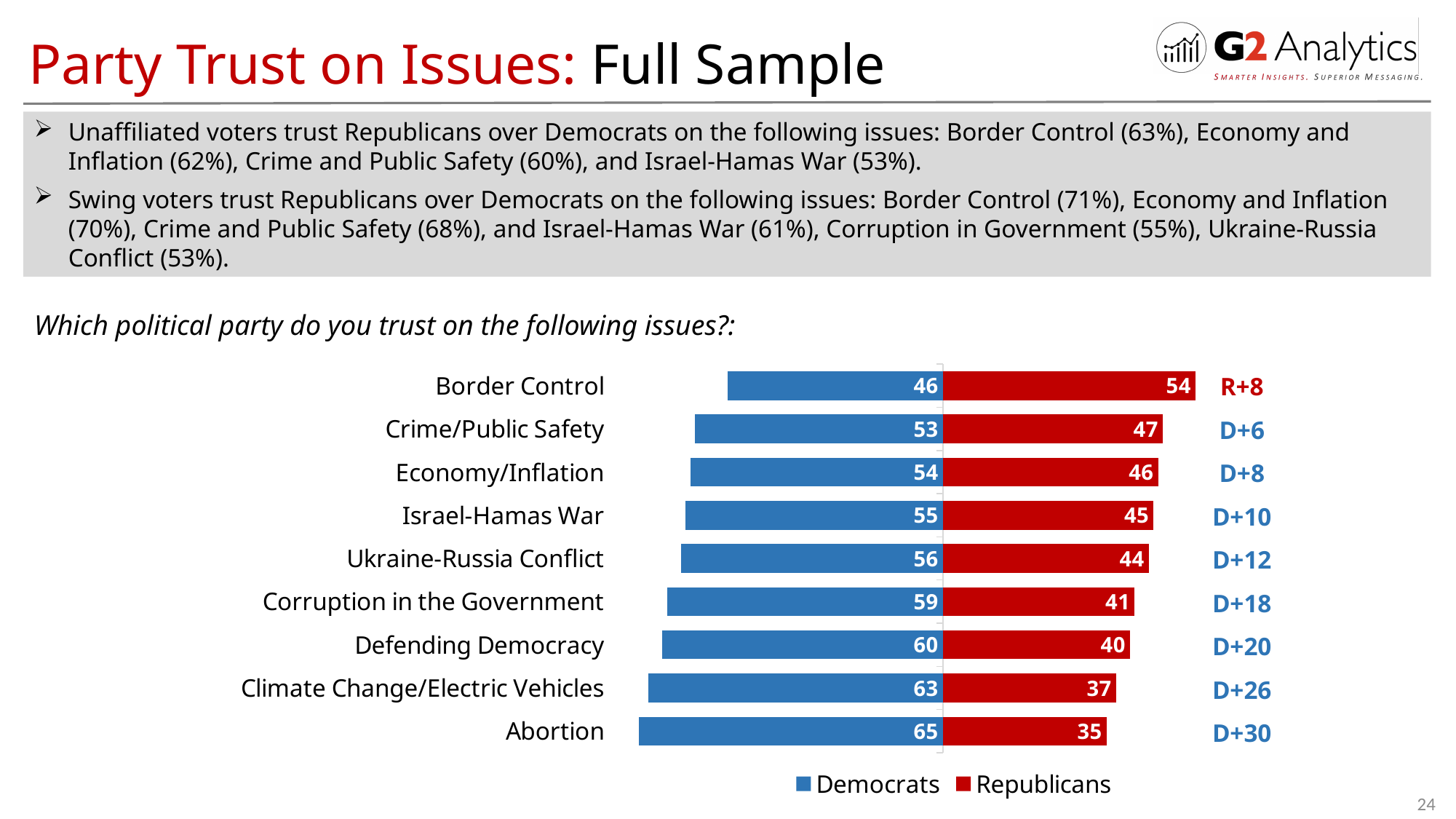
How many issues are shown in the chart? 9 Which issue has the highest Republicans value? Border Control What is the Democrats value for Corruption in the Government? 59 How many series does the legend list? 2 What is the total of the Democrats and Republicans values for Ukraine-Russia Conflict? 100 What is the difference between the Democrats and Republicans values for Defending Democracy? 20 Which issue has the lowest Republicans value? Abortion Which issue has the highest Democrats value? Abortion What kind of chart is shown on the slide? Bar chart What is the Republicans value for Abortion? 35 Which is larger for Crime/Public Safety, the Democrats value or the Republicans value? Democrats What is the Democrats value for Border Control? 46